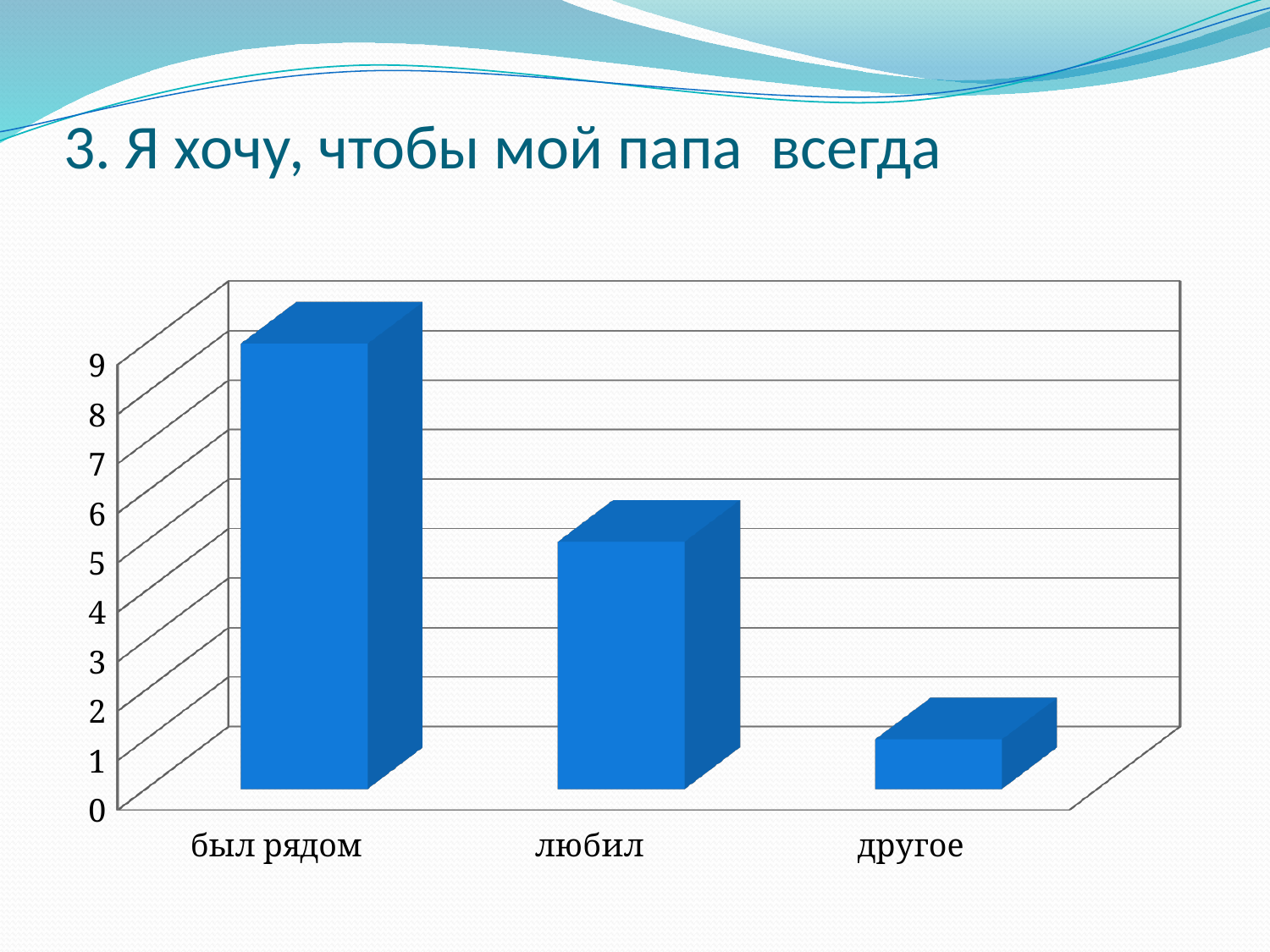
Is the value for был рядом greater or less than 7? greater Which is larger, the value for был рядом or the value for любил? был рядом Is the value for любил greater or less than 7? less What is the title of the slide above the chart? 3. Я хочу, чтобы мой папа всегда Which category has the lowest bar? другое What kind of chart is shown on the slide? bar chart Do the bar values rise or fall from left to right along the x axis? fall How many categories are shown on the x axis of the chart? 3 Which is larger, the value for любил or the value for другое? любил Is the value for любил greater or less than 4? greater Which category has the highest bar? был рядом